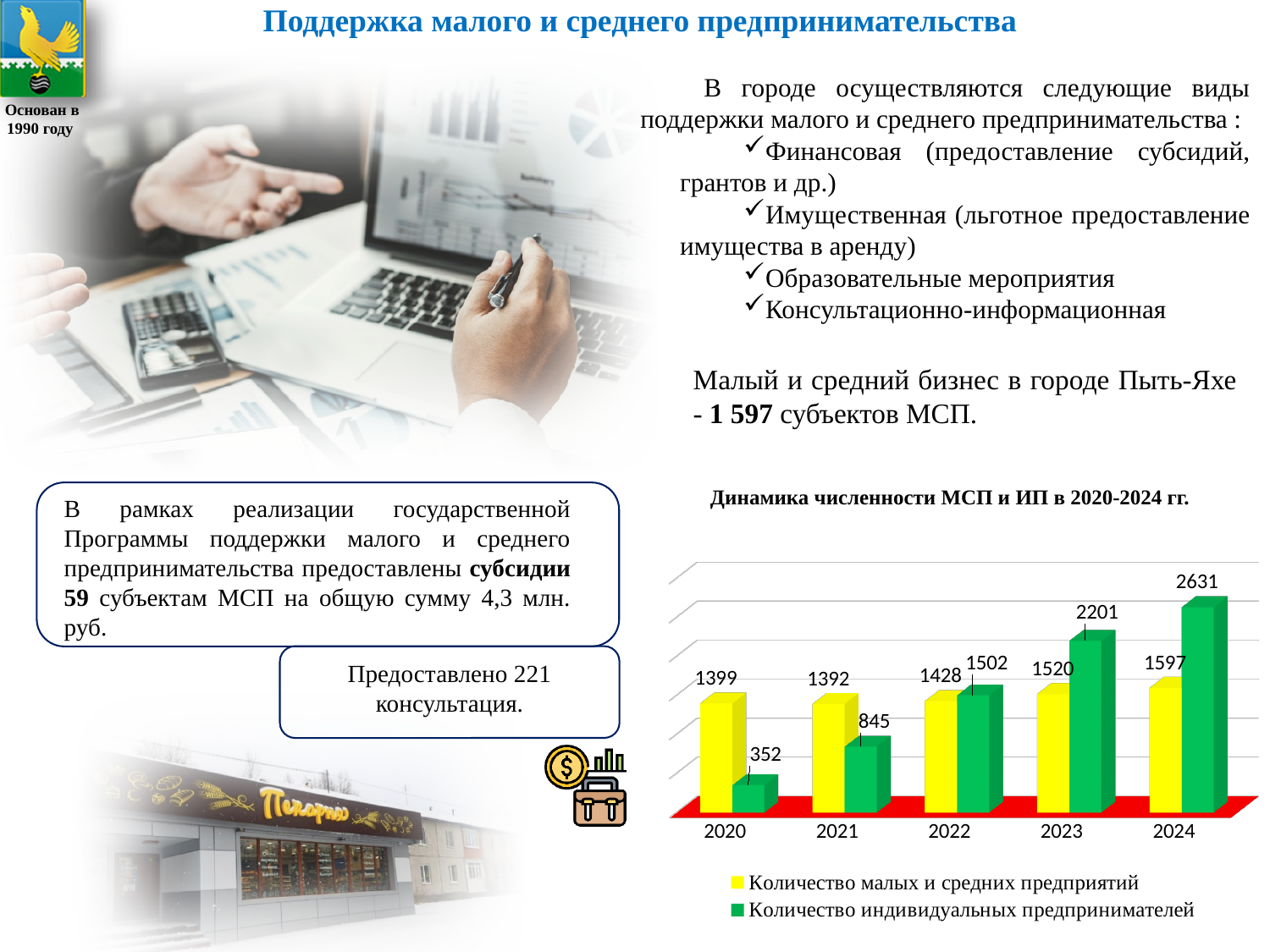
Какое значение показателя «Количество малых и средних предприятий» в 2020 году на диаграмме «Динамика численности МСП и ИП в 2020-2024 гг.»? 1399 Какое значение показателя «Количество индивидуальных предпринимателей» в 2023 году? 2201 Что больше в 2021 году: количество малых и средних предприятий или количество индивидуальных предпринимателей? Количество малых и средних предприятий Сколько рядов данных указано в легенде диаграммы? 2 Сколько лет (категорий) показано на диаграмме «Динамика численности МСП и ИП в 2020-2024 гг.»? 5 На сколько количество малых и средних предприятий в 2024 году больше, чем в 2023 году? 77 В каком году количество малых и средних предприятий было наименьшим? 2021 Какое значение показателя «Количество индивидуальных предпринимателей» в 2020 году? 352 На сколько количество индивидуальных предпринимателей в 2024 году больше, чем в 2020 году? 2279 Как меняется количество индивидуальных предпринимателей с 2020 по 2024 год — растёт или снижается? Растёт В каком году количество индивидуальных предпринимателей было наибольшим? 2024 Какого типа диаграмма «Динамика численности МСП и ИП в 2020-2024 гг.»? Столбчатая (bar chart)